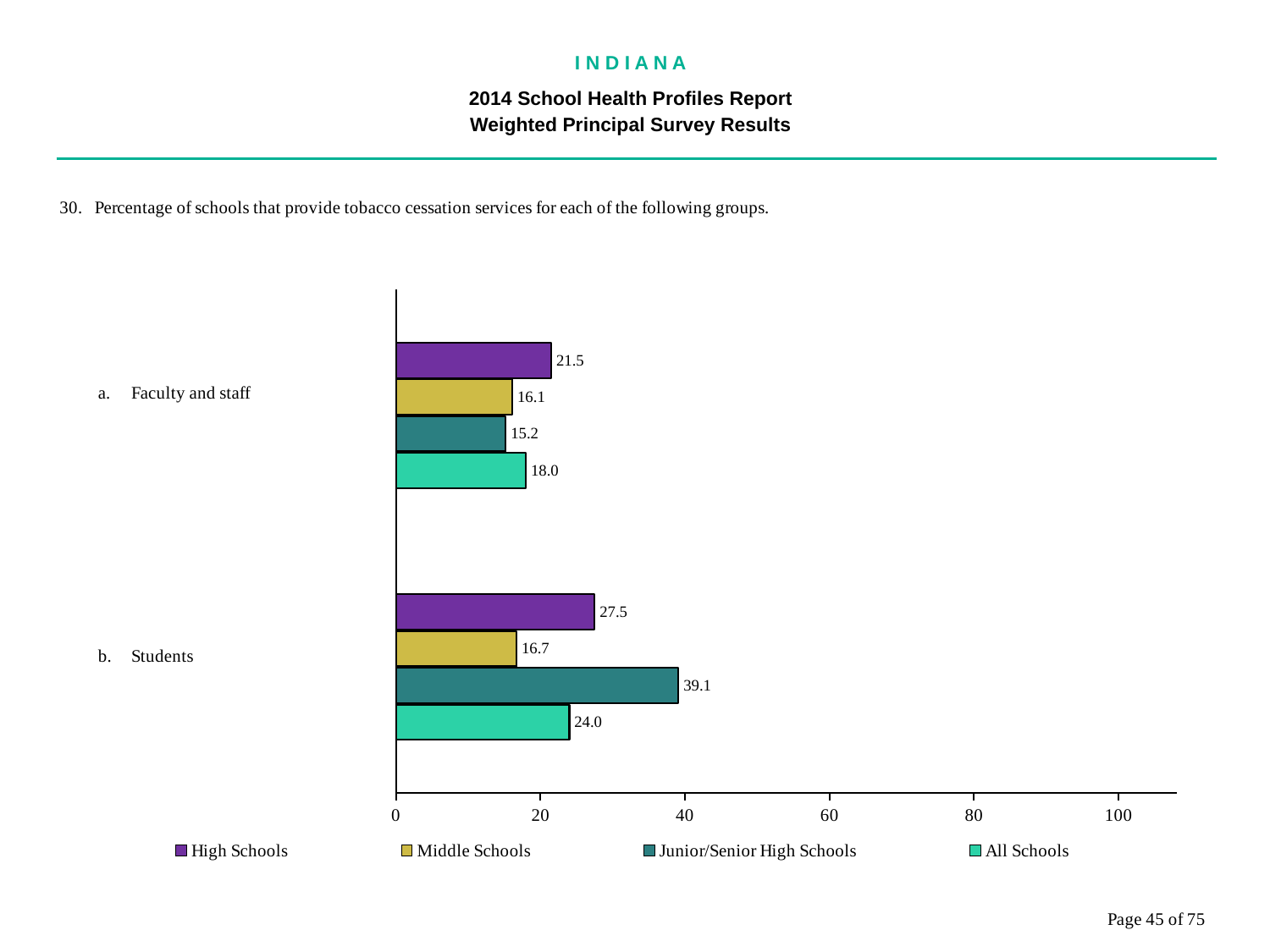
Which is larger: the All Schools value for Students or for Faculty and staff? Students Is the value for Junior/Senior High Schools in the Students category greater or less than 40? less What is the value for Middle Schools in the Students category? 16.7 What is the value for Junior/Senior High Schools in the Students category? 39.1 What kind of chart is shown on the slide? Bar chart What is the value for All Schools in the Faculty and staff category? 18.0 Which series has the highest value in the Students category? Junior/Senior High Schools What is the difference between the High Schools values for Students and Faculty and staff? 6.0 Which series has the lowest value in the Faculty and staff category? Junior/Senior High Schools What is the value for High Schools in the Faculty and staff category? 21.5 How many categories are shown on the chart? 2 How many series does the legend list? 4